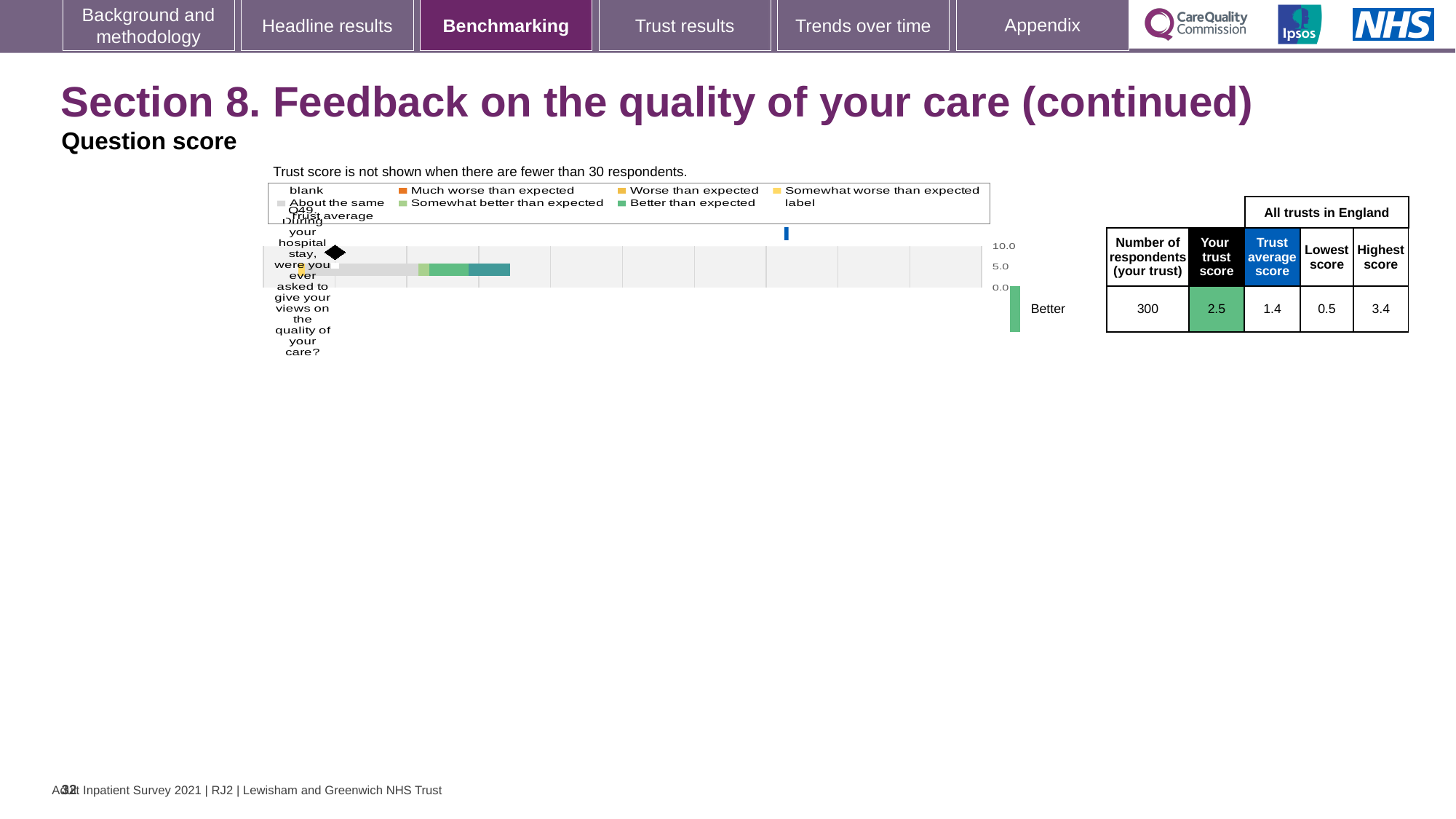
How many questions are plotted in the question score chart? 1 What is the highest score for Q49 among all trusts in England? 3.4 Which is larger for Q49: your trust score or the trust average score? your trust score What is the highest tick value shown on the chart's score axis? 10.0 Which question is shown in the question score chart? Q49. During your hospital stay, were you ever asked to give your views on the quality of your care? What kind of chart is used to show the Q49 question score? bar chart What is the trust average score for Q49 across all trusts in England? 1.4 What is the number of respondents for Q49 at your trust? 300 What is the lowest score for Q49 among all trusts in England? 0.5 What is your trust score for Q49? 2.5 What is the difference between your trust score and the trust average score for Q49? 1.1 What colour does the legend use for 'Better than expected'? teal